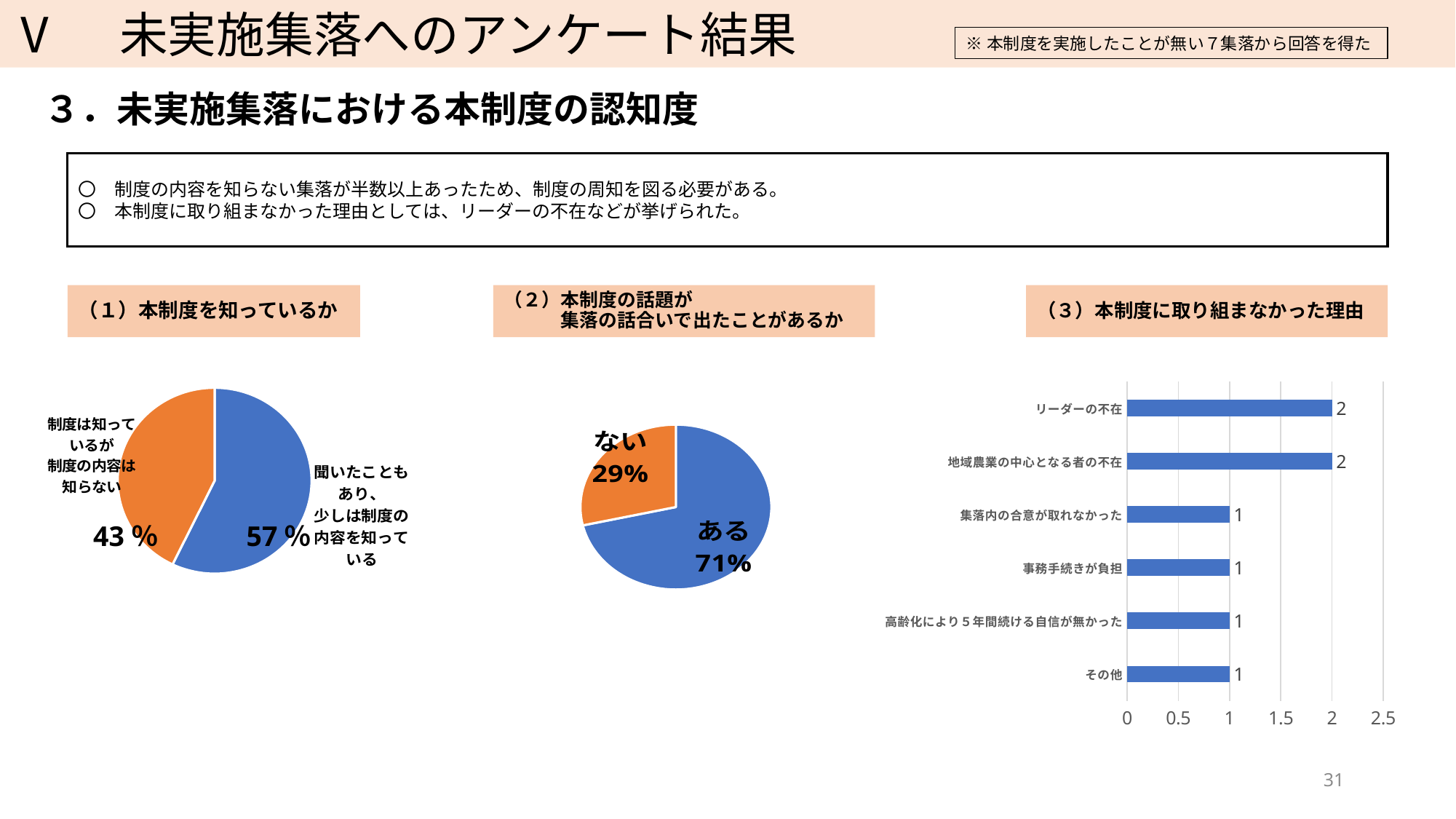
「（１）本制度を知っているか」のグラフで、「制度は知っているが制度の内容は知らない」の割合はいくらですか？ 43％ 「（２）本制度の話題が集落の話合いで出たことがあるか」のグラフで、「ある」の割合はいくらですか？ 71% 「（３）本制度に取り組まなかった理由」のグラフで、「地域農業の中心となる者の不在」と「その他」の値の差はいくらですか？ 1 「（３）本制度に取り組まなかった理由」のグラフで、「リーダーの不在」の値はいくらですか？ 2 「（３）本制度に取り組まなかった理由」のグラフには、いくつの項目がありますか？ 6 「（３）本制度に取り組まなかった理由」のグラフは、どの種類のグラフですか？ 棒グラフ 「（３）本制度に取り組まなかった理由」のグラフで、「事務手続きが負担」の値はいくらですか？ 1 「（２）本制度の話題が集落の話合いで出たことがあるか」のグラフで、「ある」と「ない」のどちらの割合が大きいですか？ ある 「（１）本制度を知っているか」のグラフで、「聞いたこともあり、少しは制度の内容を知っている」の割合はいくらですか？ 57％ 「（２）本制度の話題が集落の話合いで出たことがあるか」のグラフで、「ない」の割合はいくらですか？ 29% 「（２）本制度の話題が集落の話合いで出たことがあるか」のグラフで、「ある」と「ない」の割合の差はいくらですか？ 42% 「（１）本制度を知っているか」のグラフは、どの種類のグラフですか？ 円グラフ